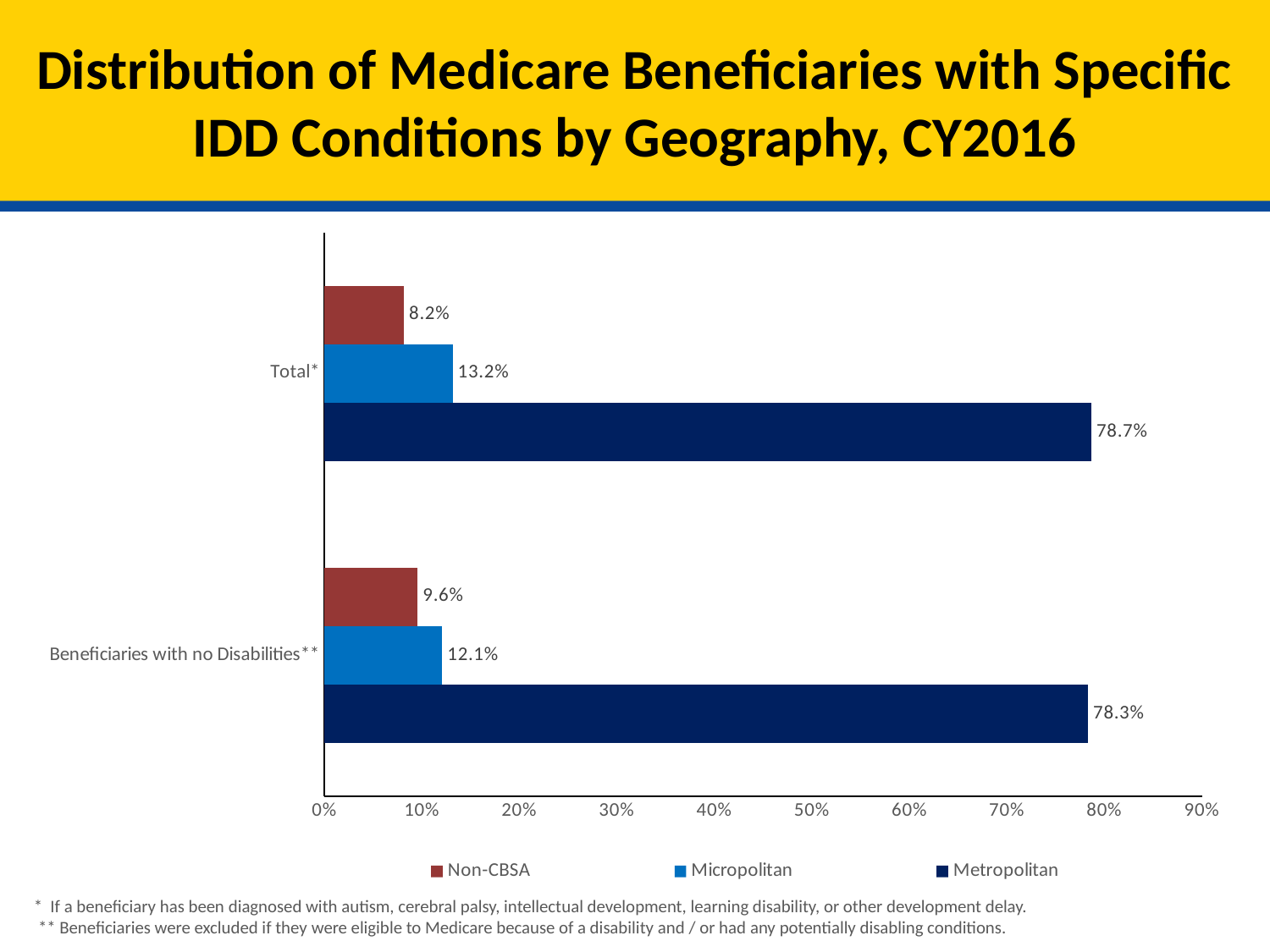
What is the difference between the Micropolitan and Non-CBSA values for Total*? 5.0% Is the Micropolitan value for Beneficiaries with no Disabilities** greater or less than 10%? greater What is the Metropolitan value for Total*? 78.7% Which geography has the lowest value for Total*? Non-CBSA What is the Micropolitan value for Total*? 13.2% What is the Non-CBSA value for Beneficiaries with no Disabilities**? 9.6% How many categories are shown on the y axis? 2 What is the difference between the Metropolitan values for Total* and Beneficiaries with no Disabilities**? 0.4% Which geography has the highest value for Beneficiaries with no Disabilities**? Metropolitan What kind of chart is shown on the slide? Bar chart Which is larger: the Non-CBSA value for Total* or the Non-CBSA value for Beneficiaries with no Disabilities**? Beneficiaries with no Disabilities** How many series does the legend list? 3